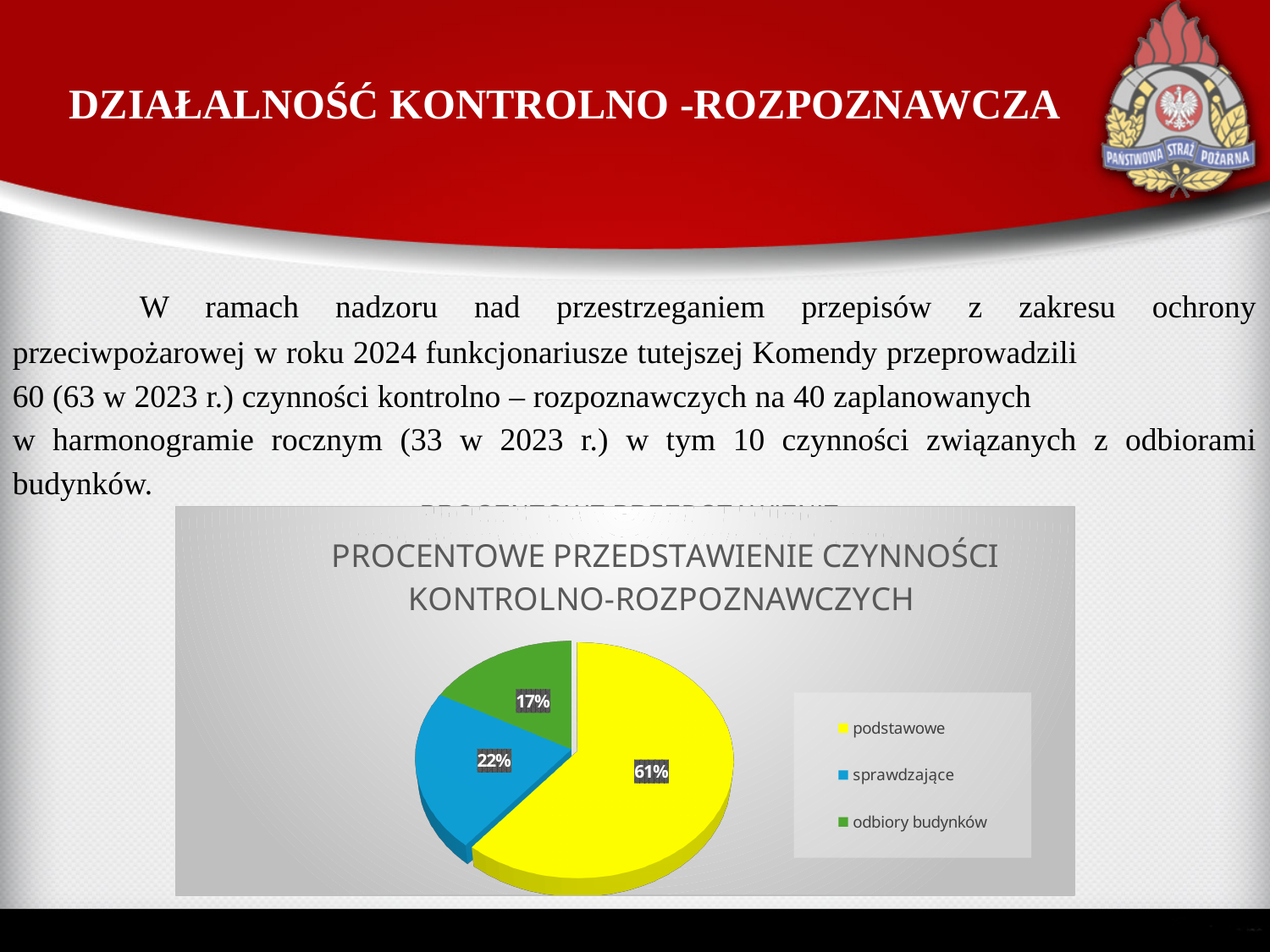
Which slice is larger, 'sprawdzające' or 'odbiory budynków'? sprawdzające What share of the pie does the 'odbiory budynków' slice represent? 17% How many categories does the pie chart show? 3 How many entries does the legend list? 3 What is the difference in percentage points between the 'podstawowe' and 'sprawdzające' slices? 39 What is the title of the chart? PROCENTOWE PRZEDSTAWIENIE CZYNNOŚCI KONTROLNO-ROZPOZNAWCZYCH What kind of chart is shown on the slide? pie chart What share of the pie does the 'sprawdzające' slice represent? 22% What share of the pie does the 'podstawowe' slice represent? 61% Which category has the smallest slice of the pie? odbiory budynków What colour is the 'podstawowe' slice? yellow Which category has the largest slice of the pie? podstawowe